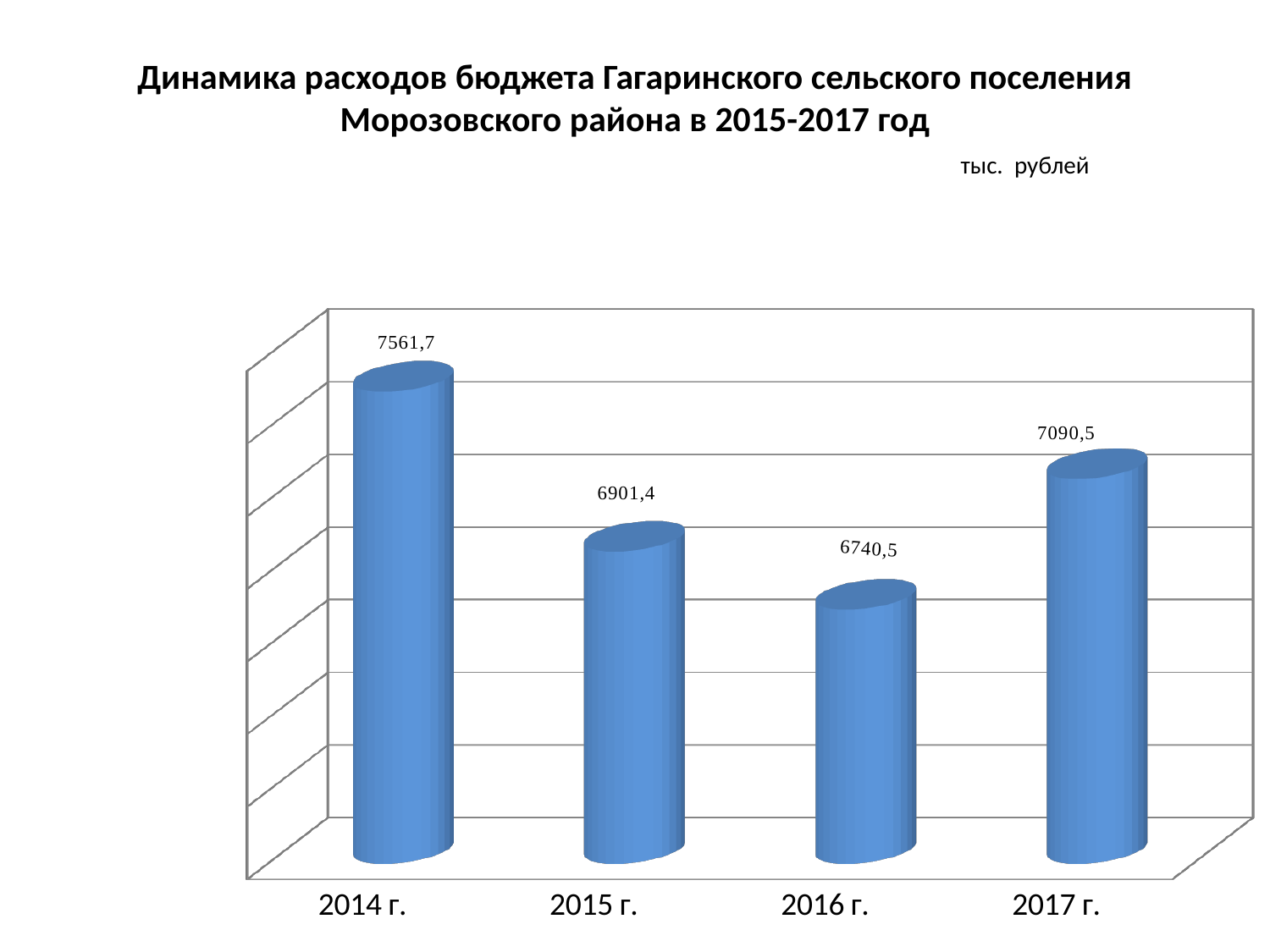
What is the value for 2016 г.? 6740,5 Which year has the highest value? 2014 г. What is the value for 2014 г.? 7561,7 What is the value for 2015 г.? 6901,4 How many years are shown on the chart? 4 What is the difference between the values for 2014 г. and 2015 г.? 660,3 What kind of chart is shown on the slide? Bar chart What is the difference between the values for 2017 г. and 2016 г.? 350 Which is larger, the value for 2015 г. or the value for 2017 г.? 2017 г. Which year has the lowest value? 2016 г. Do the values rise or fall from 2014 г. to 2016 г.? Fall What is the value for 2017 г.? 7090,5